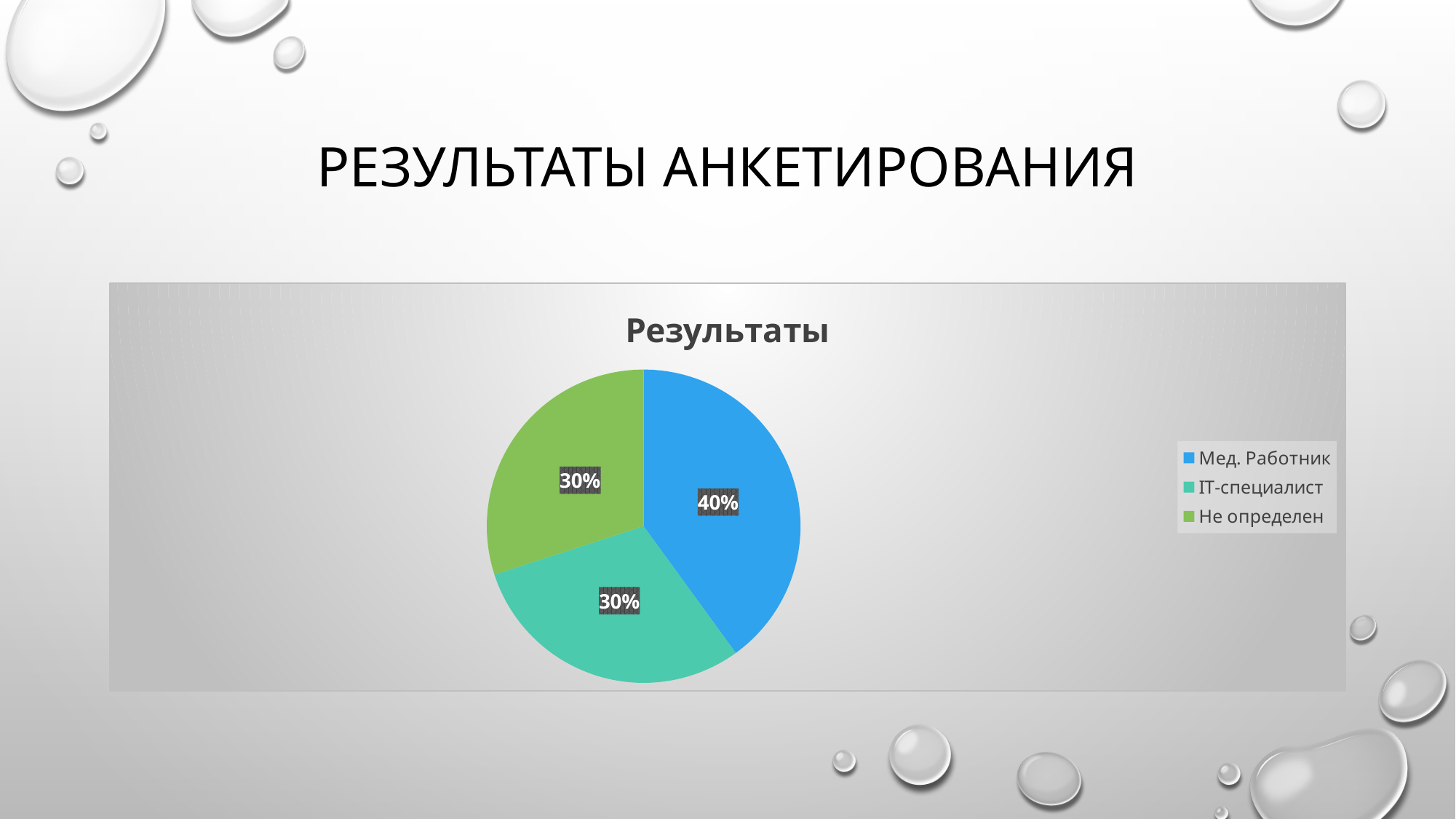
What share of the pie does Не определен have? 30% What share of the pie does Мед. Работник have? 40% What is the difference between the share for Мед. Работник and the share for IT-специалист? 10% Which category has the largest slice of the pie? Мед. Работник What kind of chart is shown on the slide? pie chart What is the title of the chart? Результаты Which is larger, the share for Мед. Работник or the share for Не определен? Мед. Работник What share of the pie does IT-специалист have? 30% What colour is the slice for Не определен? green How many slices does the pie chart have? 3 How many entries does the legend list? 3